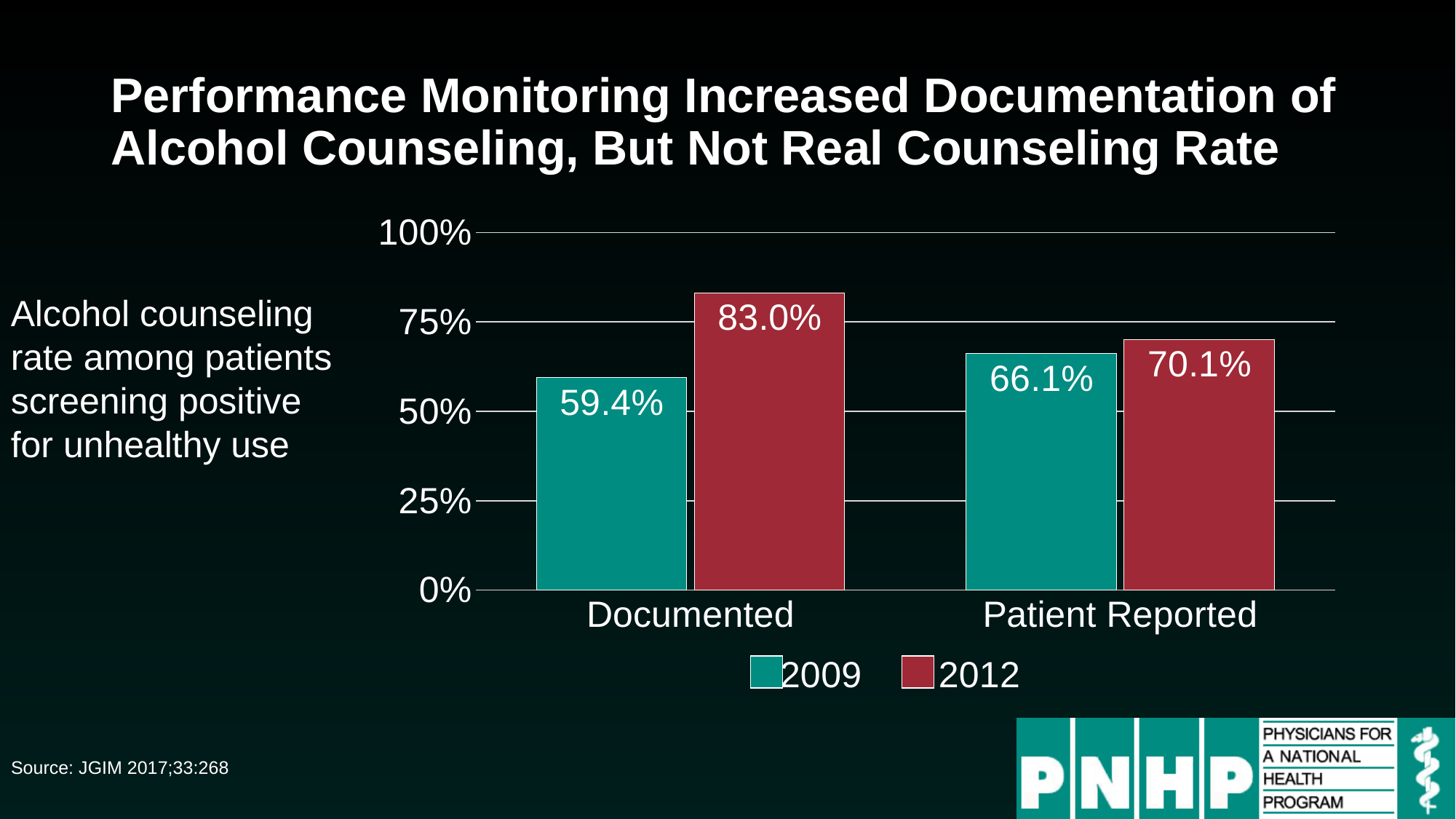
Which colour represents the 2012 series in the chart? Red What is the Documented alcohol counseling rate for 2009? 59.4% What is the Patient Reported alcohol counseling rate for 2009? 66.1% By how many percentage points did the Patient Reported rate increase from 2009 to 2012? 4.0 percentage points Which bar shows the highest value on the chart? Documented, 2012 By how many percentage points did the Documented rate increase from 2009 to 2012? 23.6 percentage points Which is larger: the 2009 Documented rate or the 2009 Patient Reported rate? 2009 Patient Reported What is the Documented alcohol counseling rate for 2012? 83.0% Which bar shows the lowest value on the chart? Documented, 2009 What kind of chart is shown on the slide? Bar chart What is the Patient Reported alcohol counseling rate for 2012? 70.1% How many series does the legend list? 2